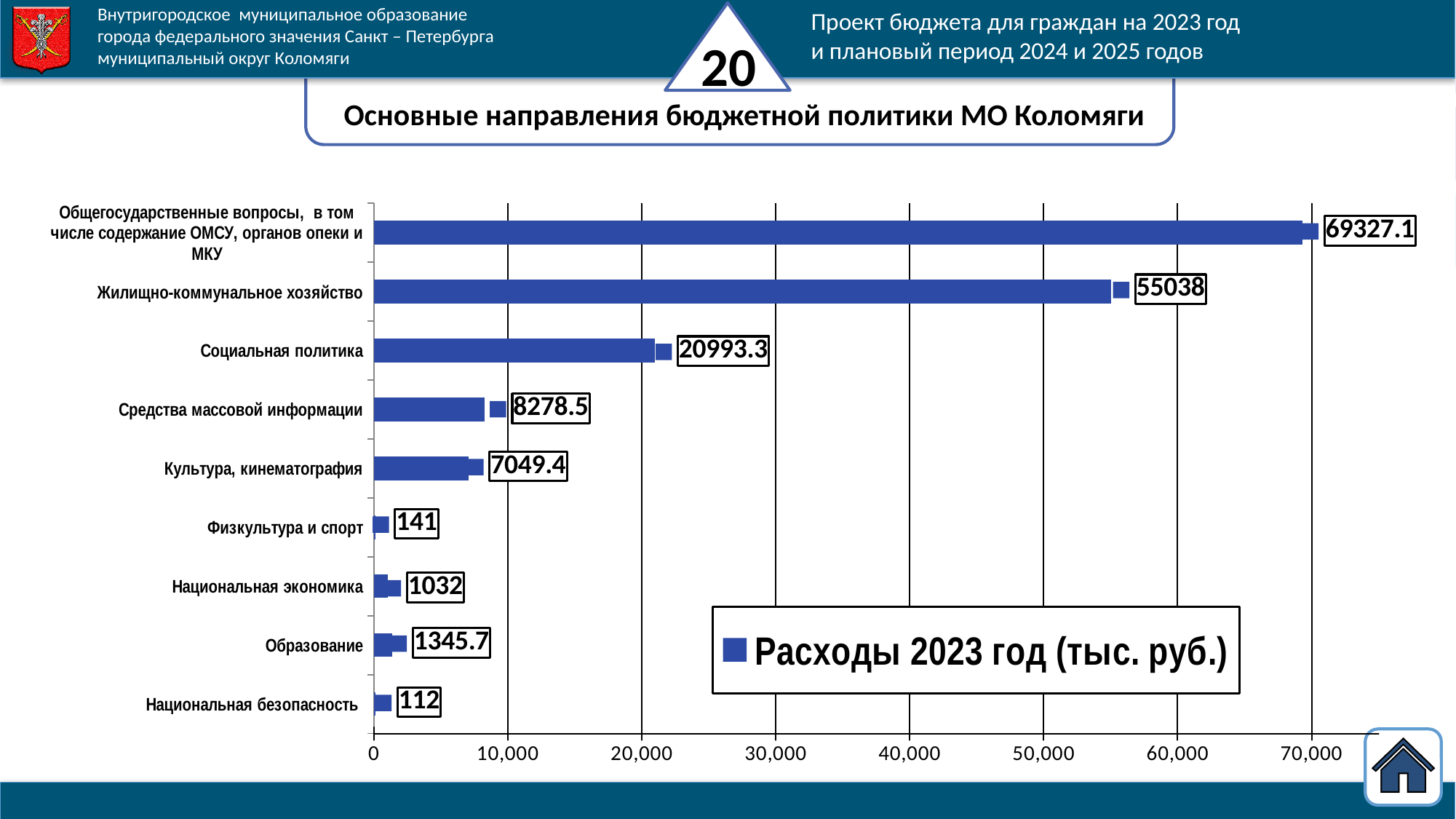
Which category has the lowest value? Национальная безопасность Which is larger: the value for Национальная экономика or the value for Образование? Образование What is the value for Образование? 1345.7 What is the difference between the values for Средства массовой информации and Культура, кинематография? 1229.1 What is the legend entry of the series shown in the chart? Расходы 2023 год (тыс. руб.) How many categories are shown in the chart? 9 What is the value for Жилищно-коммунальное хозяйство? 55038 What type of chart is shown on the slide? bar chart What is the value for Социальная политика? 20993.3 Which category has the highest value? Общегосударственные вопросы, в том числе содержание ОМСУ, органов опеки и МКУ What is the value for Культура, кинематография? 7049.4 How many series does the legend list? 1